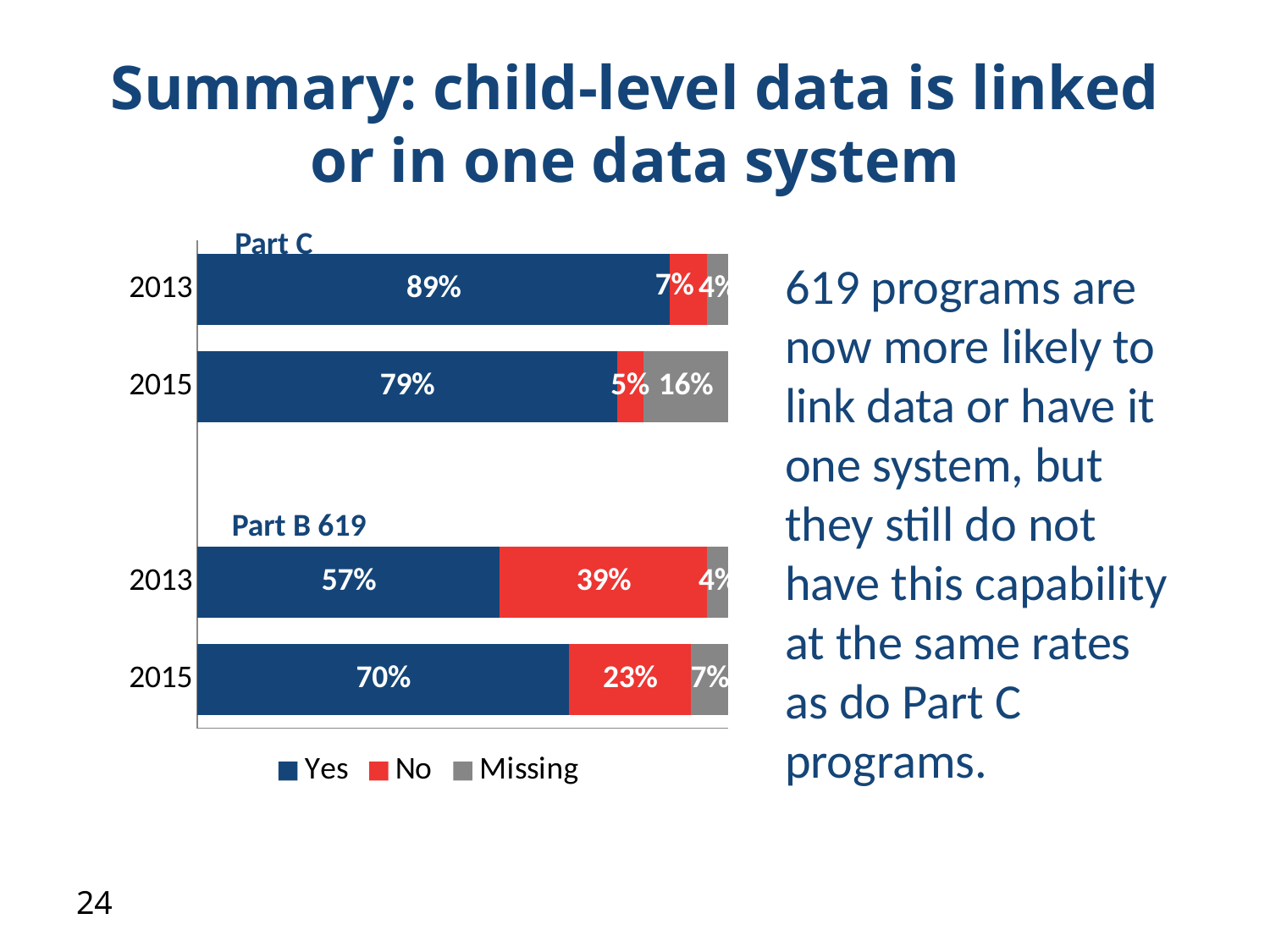
By how many percentage points did the Yes share for Part B 619 change from 2013 to 2015? 13 percentage points How many bars are plotted in the chart? 4 Which colour represents the No responses in the chart? Red How many series does the legend list? 3 What percentage of Part C programs answered Yes in 2013? 89% What percentage of Part B 619 programs answered Yes in 2015? 70% Which bar has the highest Yes percentage? Part C 2013 Which bar has the lowest Yes percentage? Part B 619 2013 What is the Missing share for Part C in 2015? 16% What percentage of Part B 619 programs answered No in 2013? 39% Which is larger: the No share for Part B 619 in 2013 or in 2015? 2013 What kind of chart is shown on the slide? Stacked bar chart